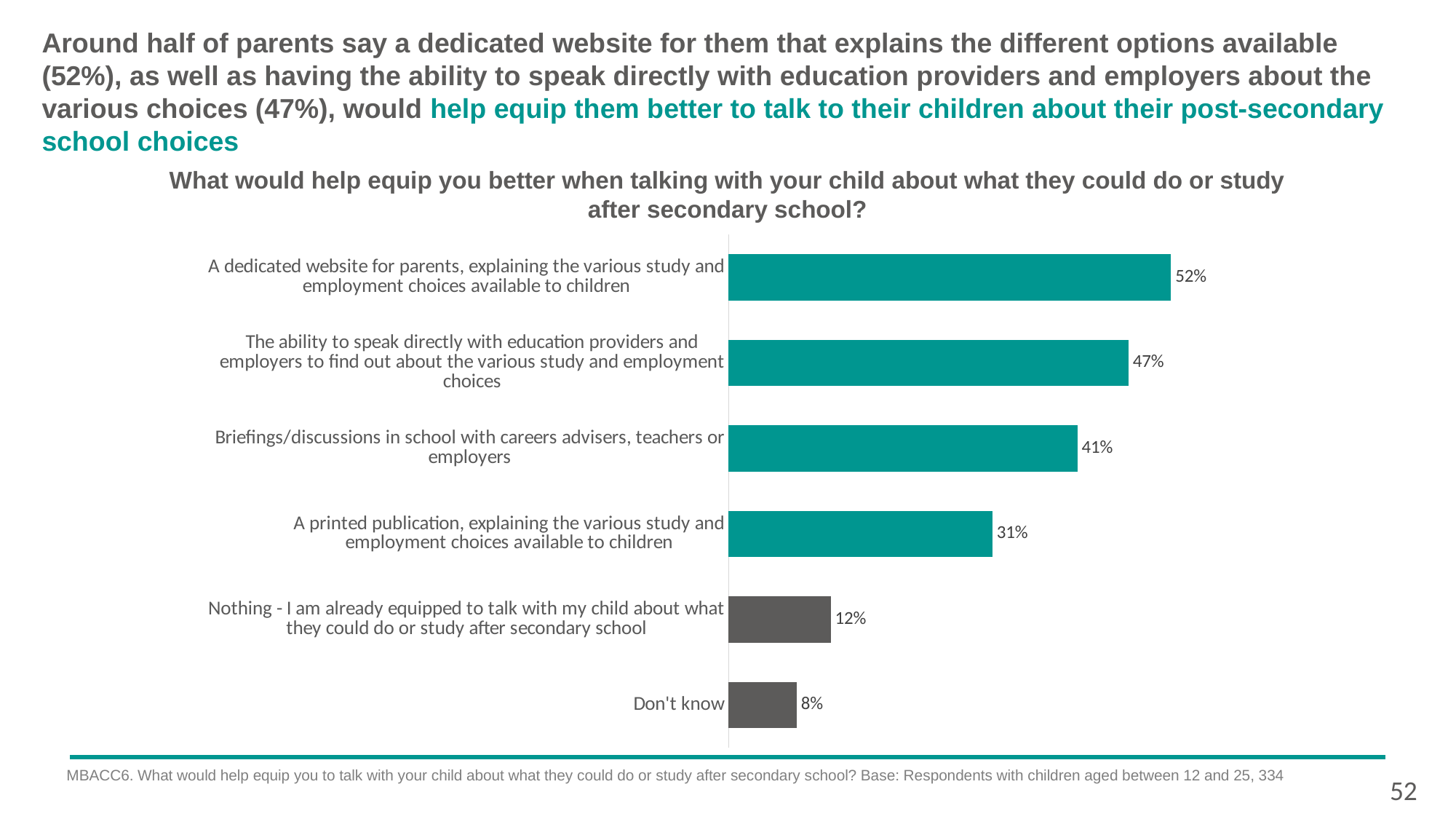
What is the difference in percentage points between 'Nothing - I am already equipped' (12%) and 'Don't know' (8%)? 4 percentage points What type of chart is shown on the slide? Bar chart What percentage of parents say a dedicated website for parents, explaining the various study and employment choices available to children, would help equip them better? 52% What percentage of respondents answered 'Don't know'? 8% Which is larger: the value for 'The ability to speak directly with education providers and employers' or the value for 'Briefings/discussions in school with careers advisers, teachers or employers'? The ability to speak directly with education providers and employers What is the value for 'Nothing - I am already equipped to talk with my child about what they could do or study after secondary school'? 12% What is the difference in percentage points between the dedicated website option (52%) and the printed publication option (31%)? 21 percentage points Which option has the lowest percentage? Don't know How many categories are shown in the chart? 6 How many bars in the chart are coloured grey rather than teal? 2 What is the value for 'Briefings/discussions in school with careers advisers, teachers or employers'? 41% Which option has the highest percentage? A dedicated website for parents, explaining the various study and employment choices available to children